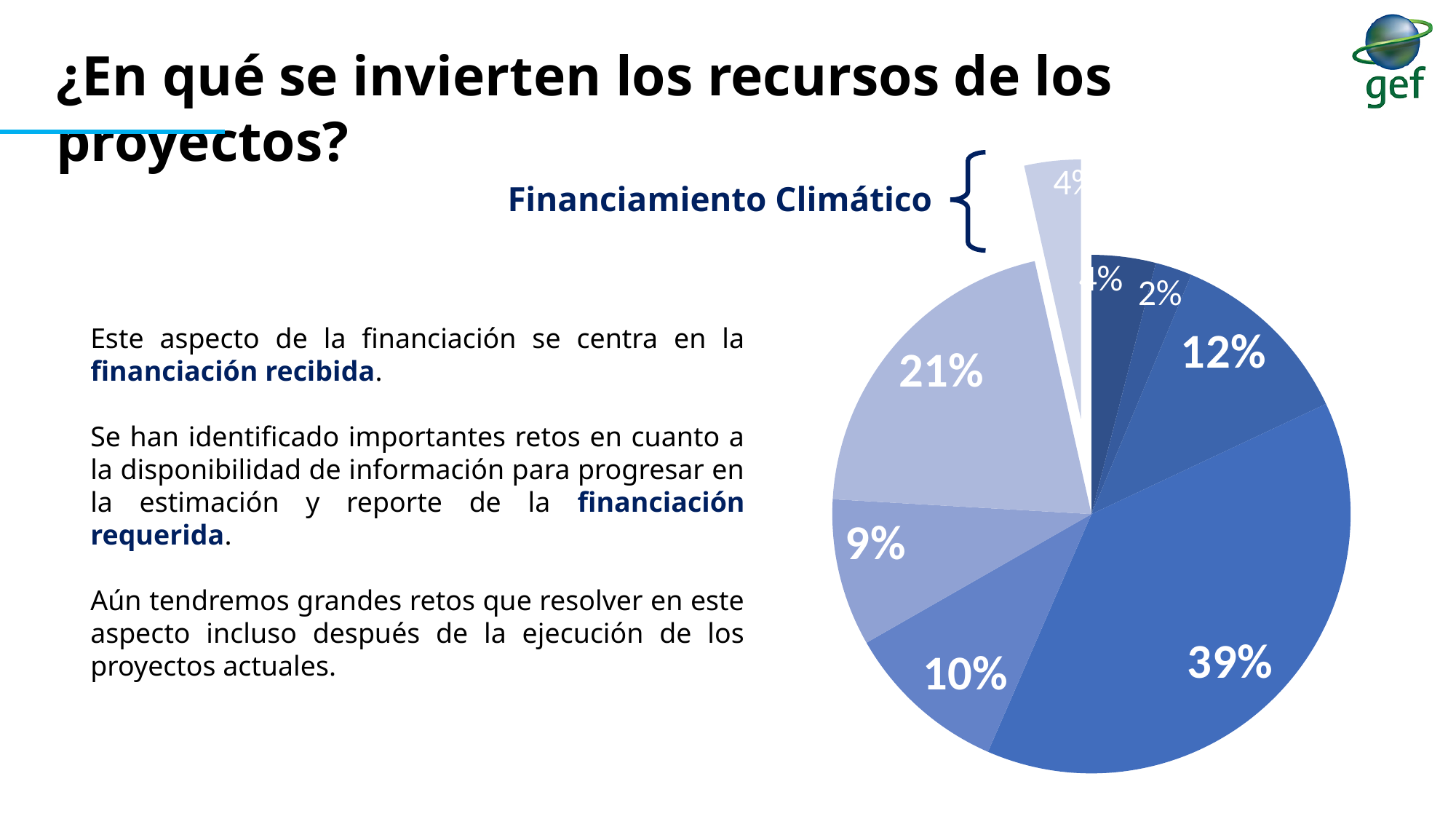
What is the difference in percentage points between the largest slice (39%) and the 21% slice? 18 How many slices does the pie chart have? 8 Which is larger, the 12% slice or the 10% slice? 12% Is the largest slice of the pie chart greater or less than 50%? less What percentage is shown for the largest slice of the pie chart? 39% What kind of chart is shown on the slide? pie chart What is the combined share of the 10% and 9% slices? 19% Which slice is larger, the 21% slice or the 9% slice? 21% What percentage is shown for the smallest slice of the pie chart? 2% What is the difference in percentage points between the 12% slice and the 2% slice? 10 What percentage does the exploded slice labelled 'Financiamiento Climático' represent? 4% What label is attached by a bracket to the exploded slice of the pie chart? Financiamiento Climático